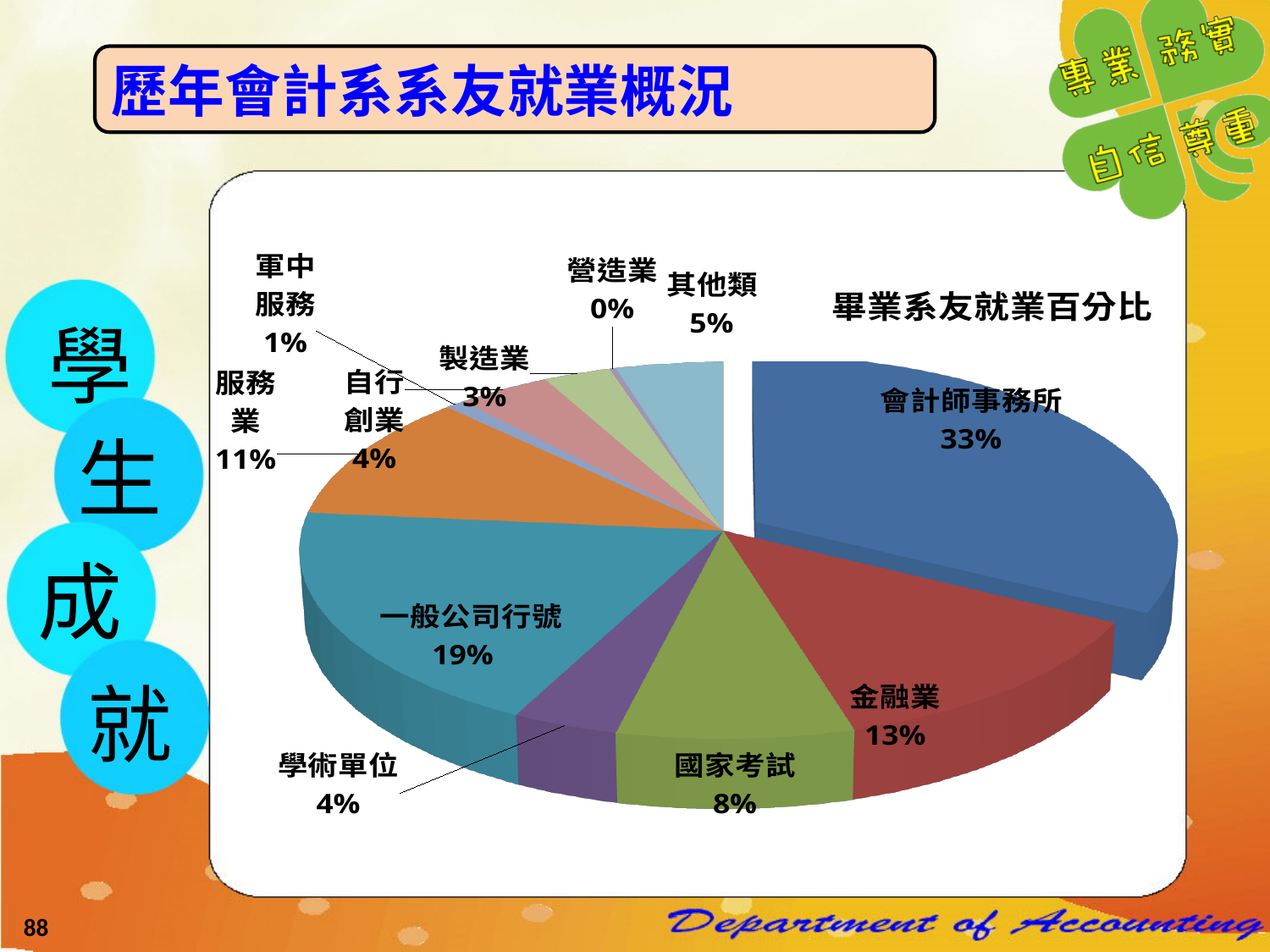
What is the difference between the shares of 會計師事務所 and 一般公司行號? 14% Which category has the largest share of the pie? 會計師事務所 Which is larger, the share of 金融業 or the share of 其他類? 金融業 What percentage of the pie is 一般公司行號? 19% What kind of chart is shown on the slide? pie chart What percentage of the pie is 服務業? 11% What percentage of the pie is 金融業? 13% Which category has the smallest share of the pie? 營造業 What is the title of the chart? 畢業系友就業百分比 What percentage of the pie is 國家考試? 8% What percentage of the pie is 會計師事務所? 33% How many categories are shown in the pie chart? 11